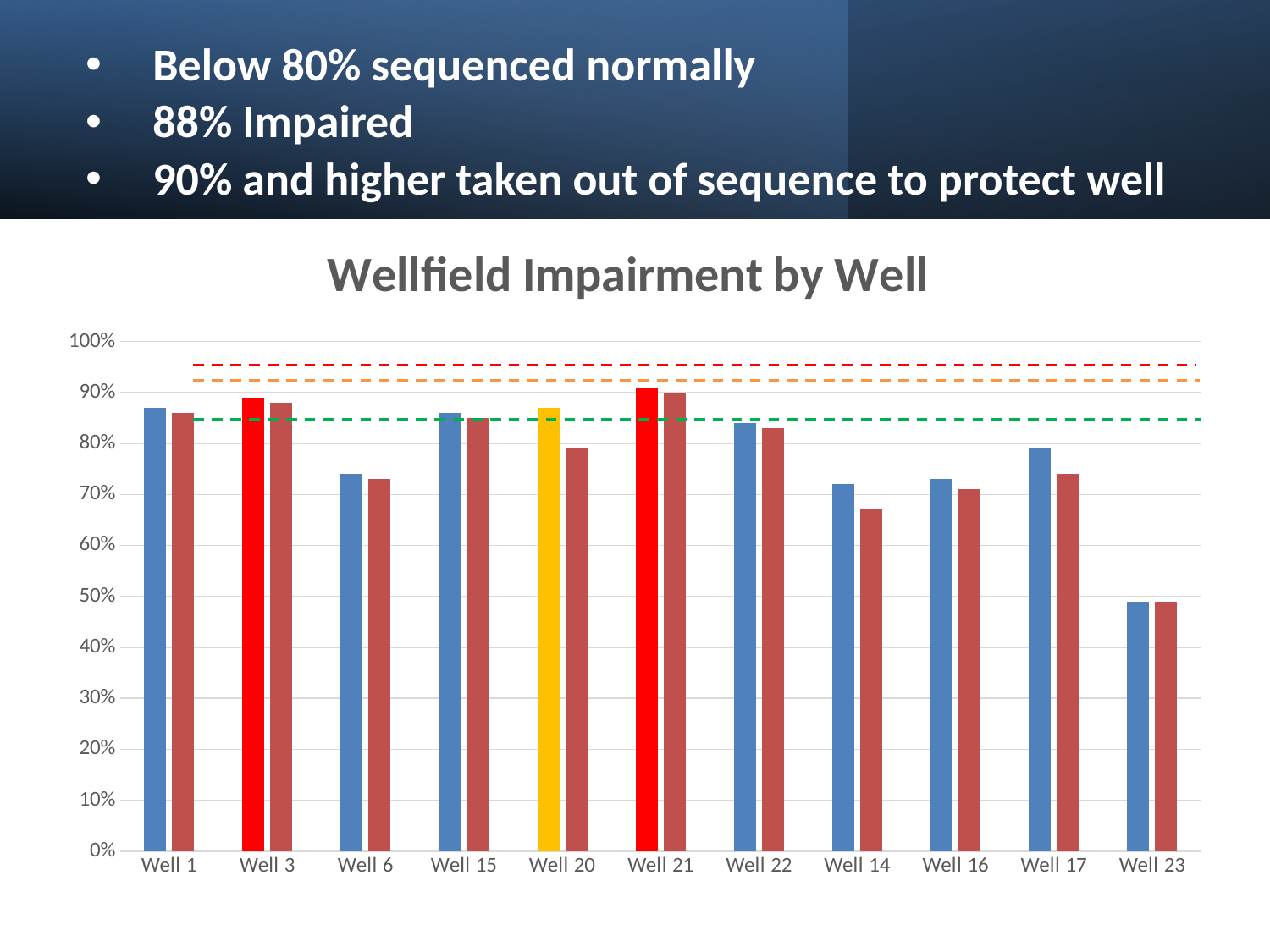
What is the title of the chart? Wellfield Impairment by Well Which has a higher first bar, Well 1 or Well 14? Well 1 How many wells are shown on the x axis of the chart? 11 What colour is the first bar for Well 20? yellow Is the value of the first bar for Well 1 greater or less than 80%? greater Is the value of the first bar for Well 23 greater or less than 60%? less What kind of chart is shown on the slide? bar chart Which well has the lowest bars in the chart? Well 23 Is the value of the second bar for Well 14 greater or less than 70%? less Which has a higher first bar, Well 6 or Well 23? Well 6